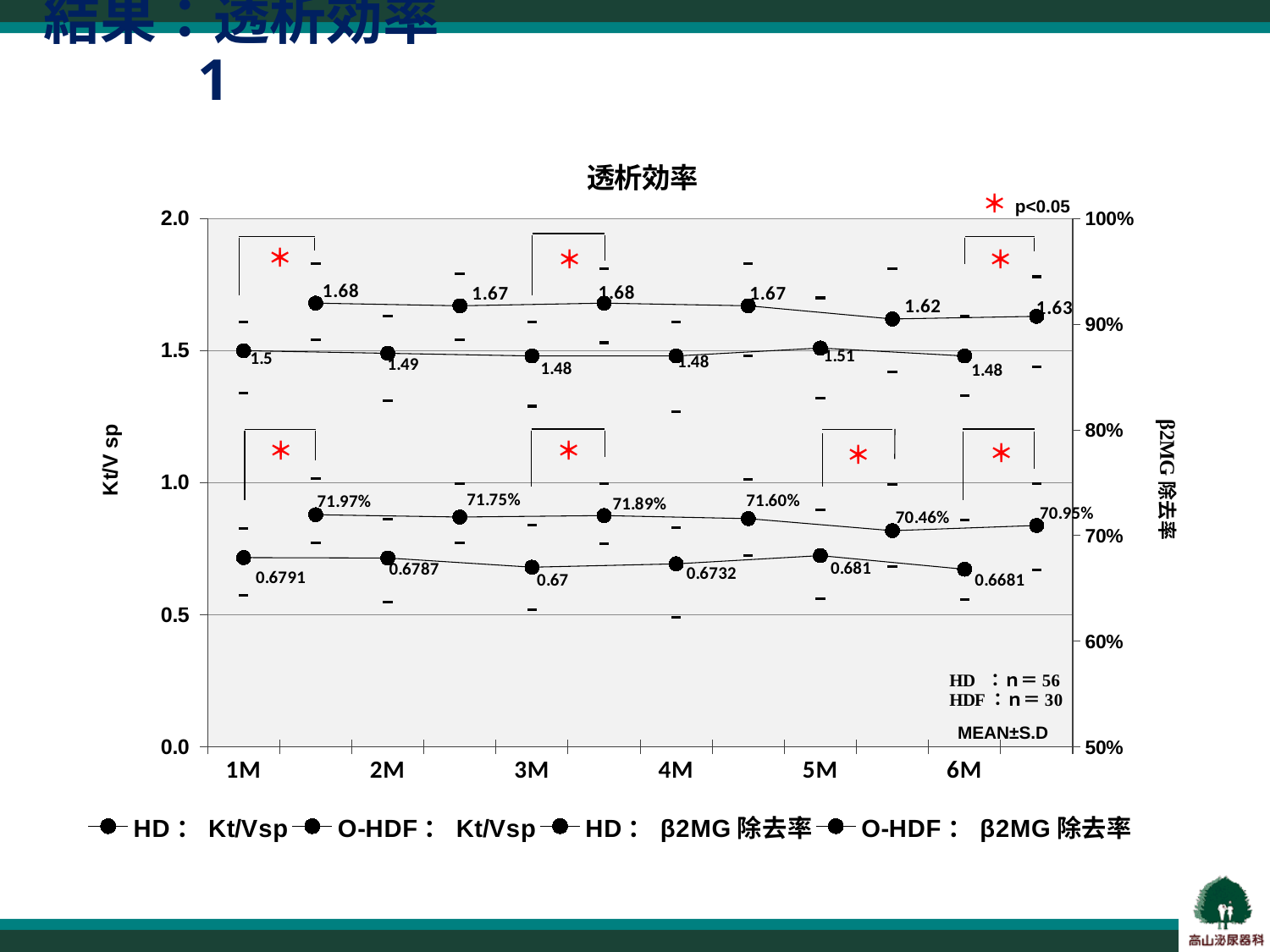
At which time point is the O-HDF β2MG 除去率 lowest? 5M What is the HD Kt/Vsp value at 5M? 1.51 At which time point is the O-HDF β2MG 除去率 highest? 1M What type of chart is shown on the slide? line chart How many time points are shown on the x axis? 6 What is the HD β2MG 除去率 value labelled at 6M? 0.6681 What is the O-HDF β2MG 除去率 value at 4M? 71.60% How many series does the chart legend list? 4 What is the O-HDF Kt/Vsp value at 1M? 1.68 Which series has the larger Kt/Vsp value at 6M, HD or O-HDF? O-HDF What is the difference between the O-HDF Kt/Vsp and HD Kt/Vsp values at 3M? 0.20 What is the title of the chart? 透析効率